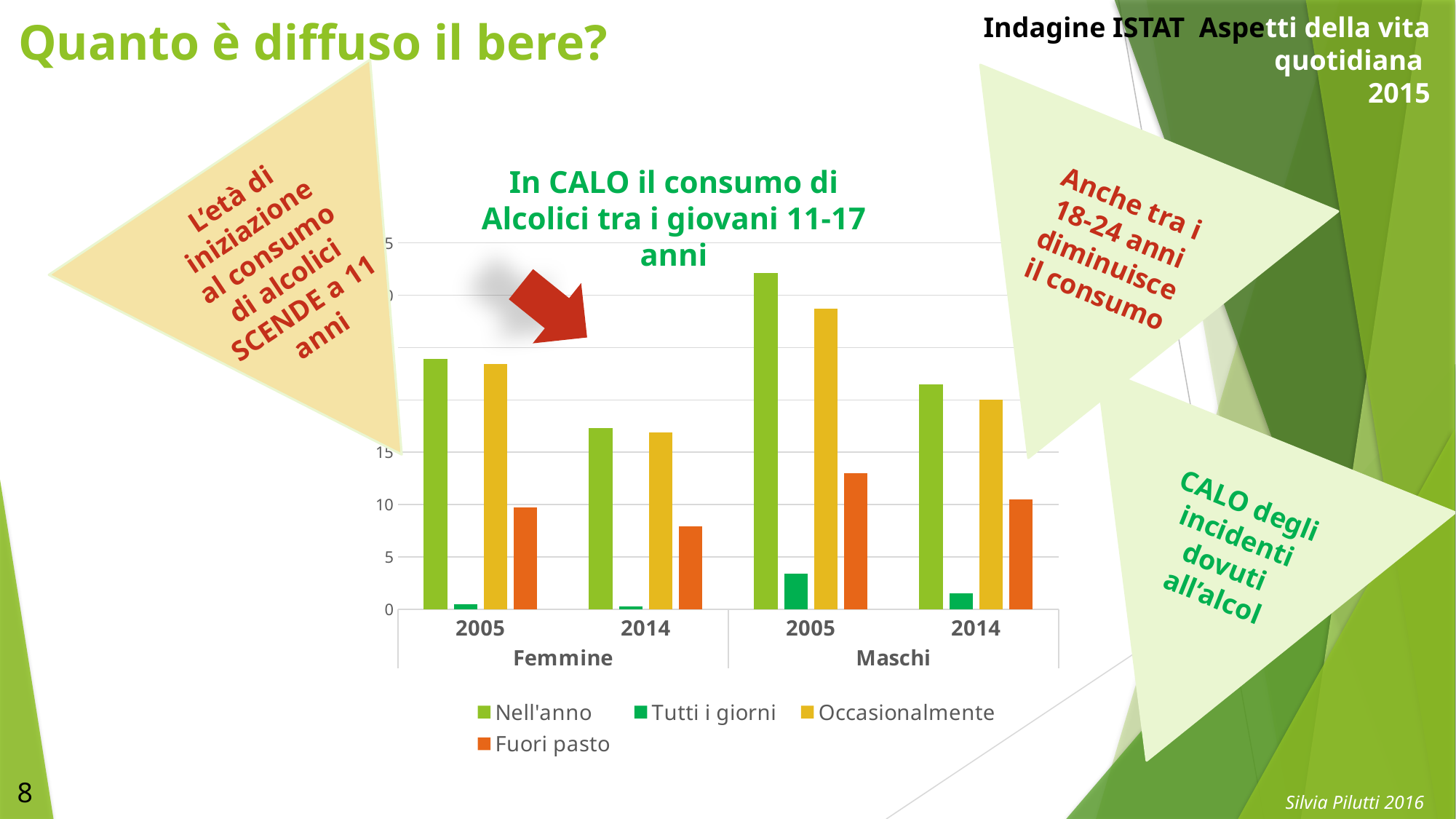
What colour represents the 'Fuori pasto' series in the legend? orange How many series does the chart legend list? 4 How many year groups of bars are plotted on the x axis? 4 Is the 'Fuori pasto' value for Maschi 2005 greater or less than 10? greater Does the 'Nell'anno' value for Femmine rise or fall from 2005 to 2014? fall In which group is the 'Nell'anno' bar highest? Maschi 2005 What kind of chart is shown on the slide? bar chart Is the 'Fuori pasto' value for Femmine 2014 greater or less than 10? less Is the 'Nell'anno' value for Femmine 2014 greater or less than 15? greater Which series has the lowest bar in every group? Tutti i giorni For Maschi 2005, which is larger: 'Nell'anno' or 'Occasionalmente'? Nell'anno